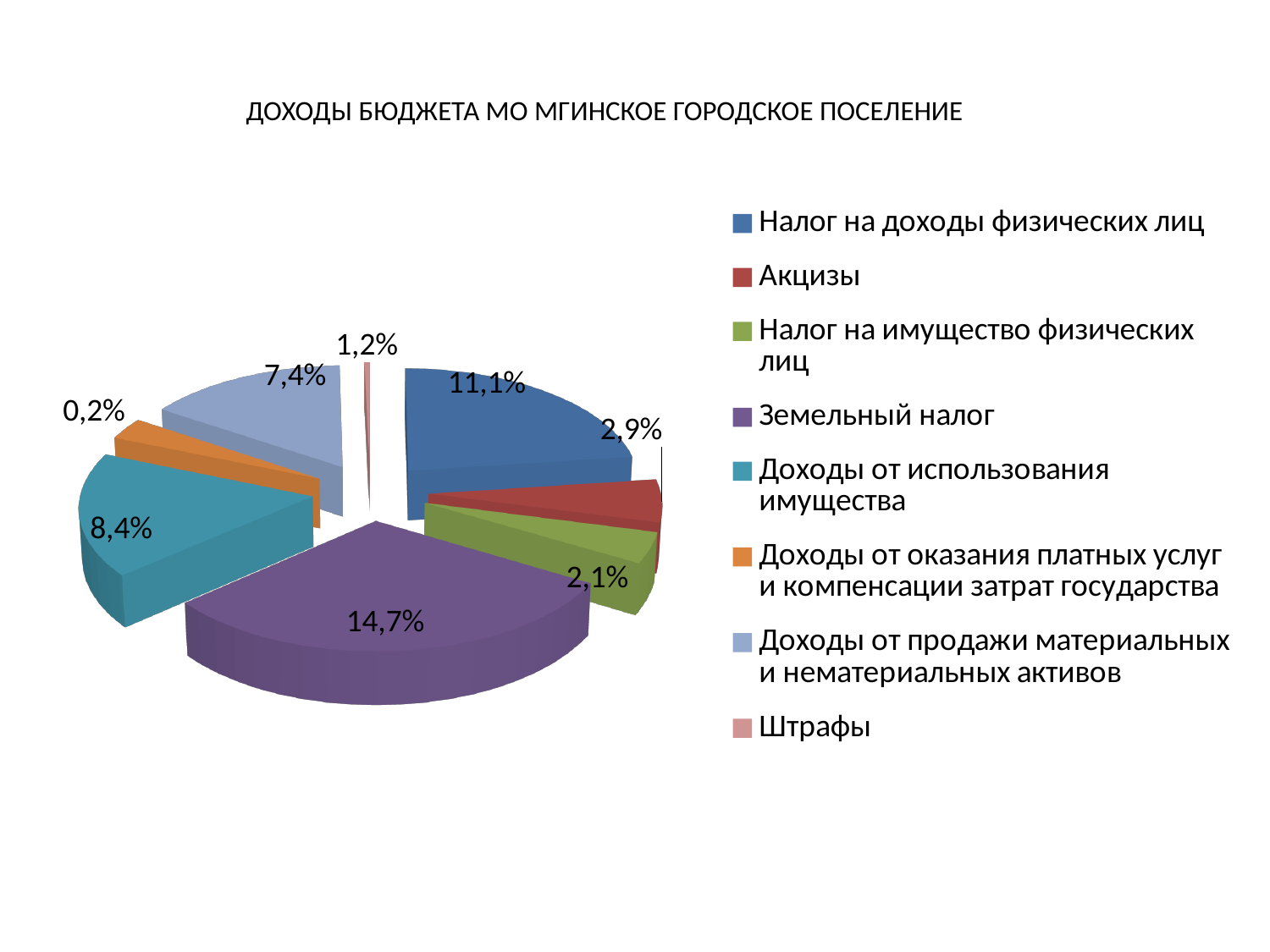
What value is shown for Земельный налог? 14,7% What value is shown for Доходы от использования имущества? 8,4% Which is larger, Налог на имущество физических лиц or Акцизы? Акцизы What is the difference between the values for Земельный налог and Налог на доходы физических лиц? 3,6% Which category has the largest slice? Земельный налог How many categories does the legend list? 8 What value is shown for Налог на доходы физических лиц? 11,1% What value is shown for Акцизы? 2,9% What value is shown for Штрафы? 1,2% What is the title of the chart? ДОХОДЫ БЮДЖЕТА МО МГИНСКОЕ ГОРОДСКОЕ ПОСЕЛЕНИЕ What type of chart is shown on the slide? Pie chart